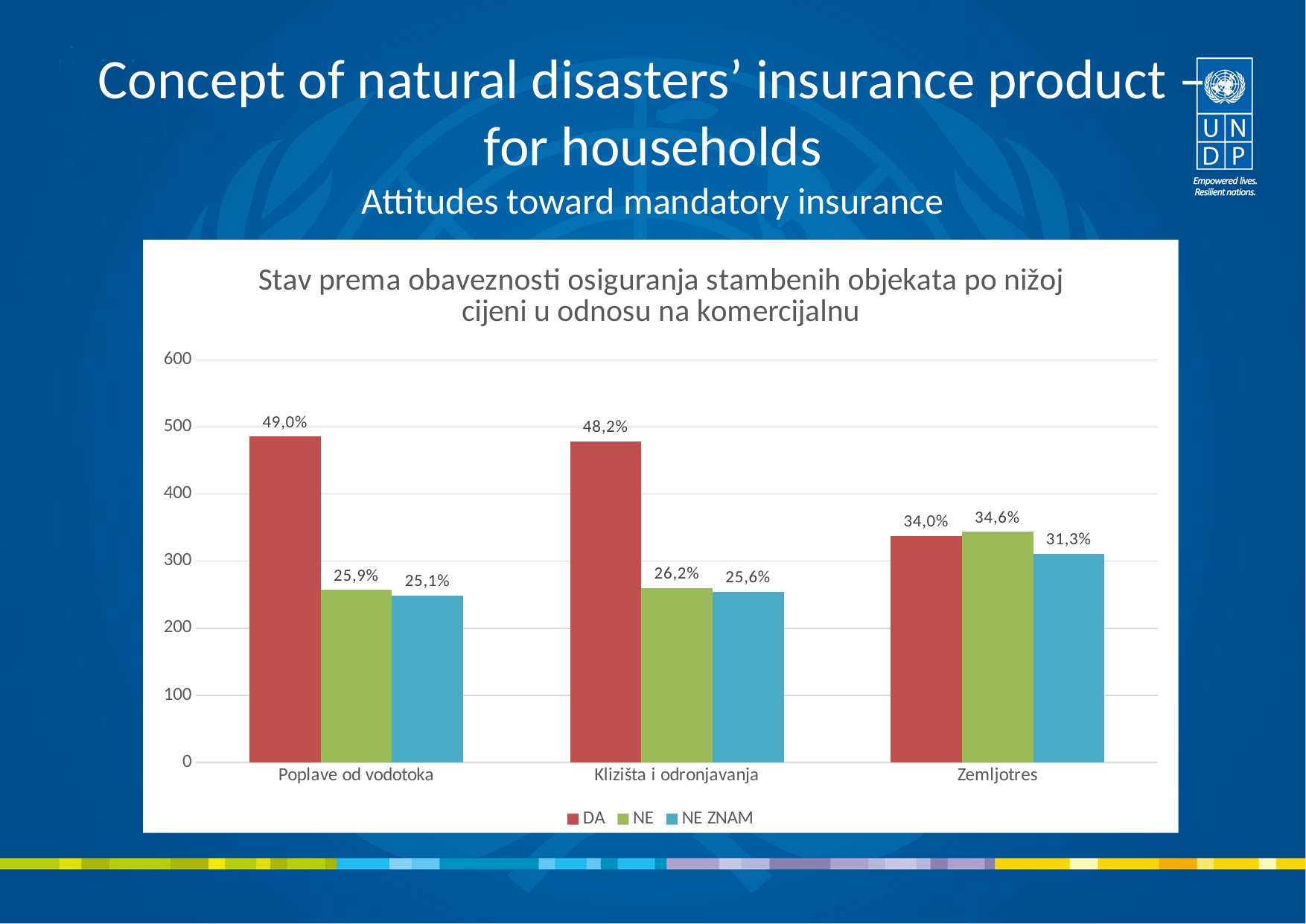
Which is larger in the Zemljotres category, DA or NE? NE Which series has the lowest value in the Poplave od vodotoka category? NE ZNAM What is the value for DA in the Poplave od vodotoka category? 49,0% What kind of chart is shown on the slide? Bar chart Which series is shown in red in the legend? DA Which category has the highest DA value? Poplave od vodotoka How many categories are shown on the x axis? 3 Is the DA bar for Klizišta i odronjavanja greater or less than 400 on the axis? greater What is the value for NE ZNAM in the Zemljotres category? 31,3% What is the value for NE in the Klizišta i odronjavanja category? 26,2% How many series does the legend list? 3 What is the difference between the DA and NE values in the Poplave od vodotoka category? 23,1 percentage points